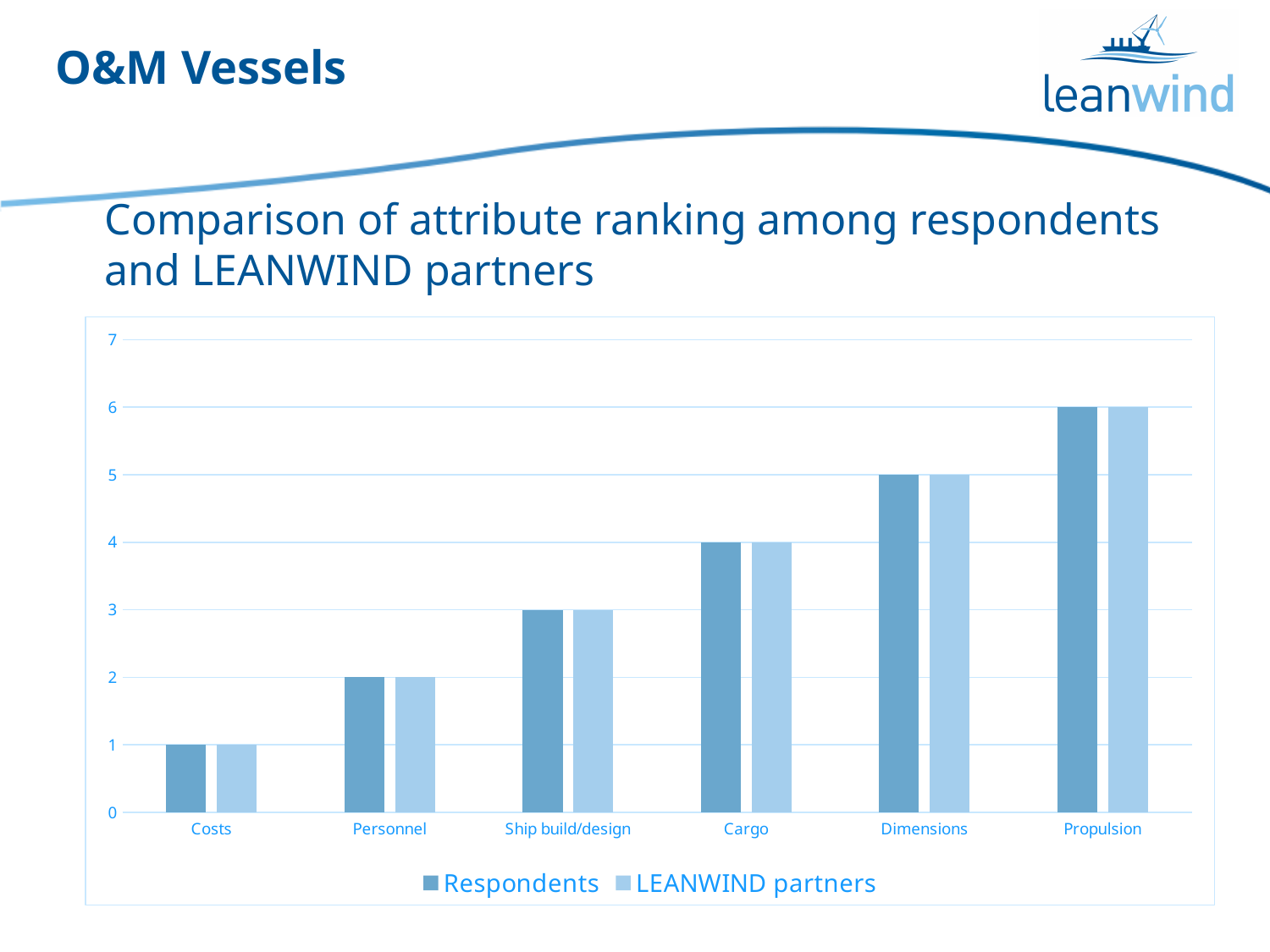
Which category has the highest Respondents value? Propulsion Do the Respondents values rise or fall from Costs to Propulsion along the x axis? rise How many series does the legend list? 2 What is the Respondents value for Cargo? 4 Is the Respondents value for Dimensions greater or less than 4? greater What is the LEANWIND partners value for Propulsion? 6 What is the difference between the Respondents values for Dimensions and Personnel? 3 What is the Respondents value for Costs? 1 Which category has the lowest LEANWIND partners value? Costs Which is larger, the LEANWIND partners value for Ship build/design or for Cargo? Cargo How many categories are shown on the x axis? 6 What kind of chart is shown on the slide? bar chart